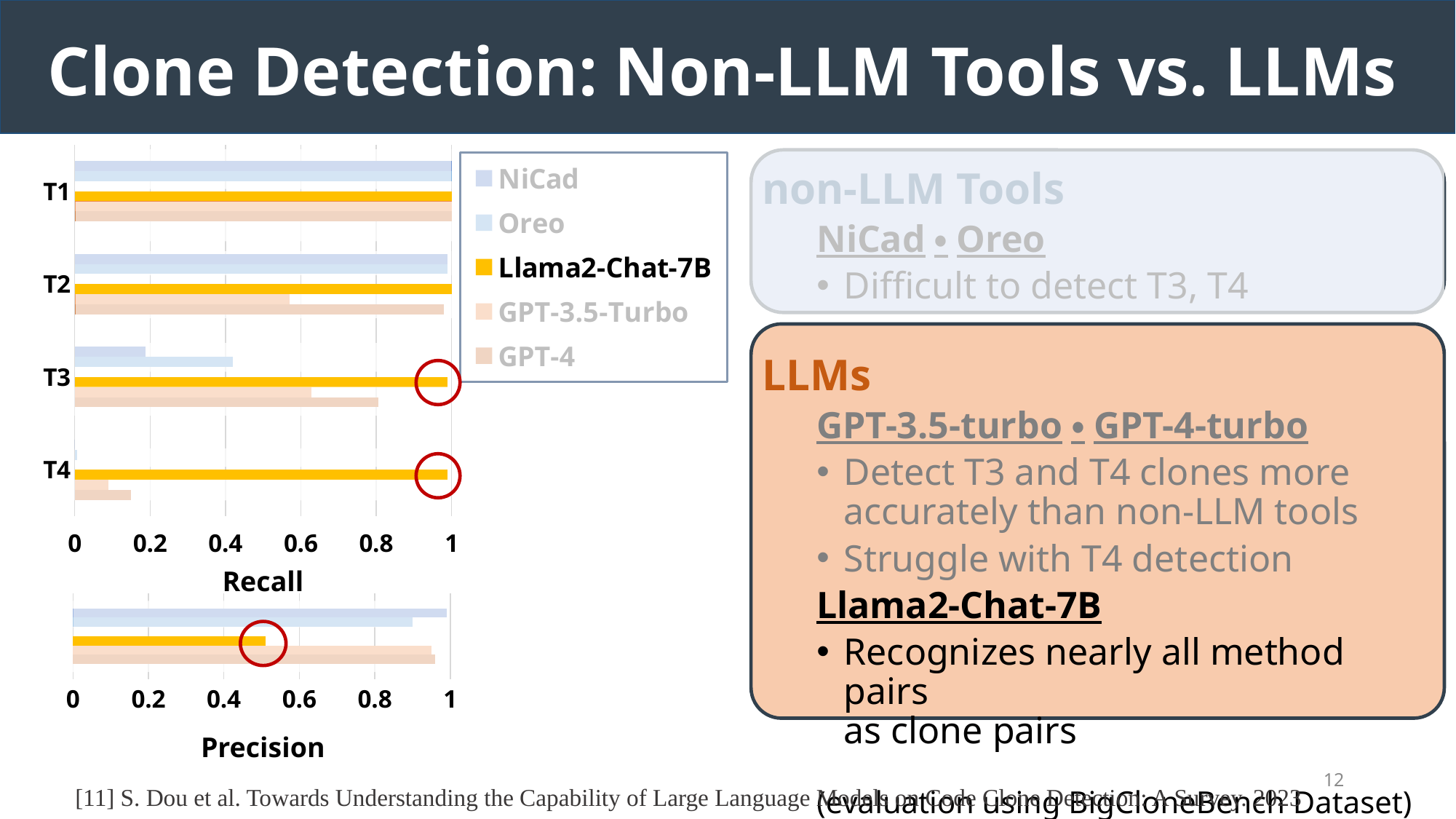
What is the x-axis label of the bottom chart on the slide? Precision How many series does the legend of the Recall chart list? 5 In the Recall chart, which series has the lowest recall for T3? NiCad What kind of chart is the Recall chart on the left of the slide? bar chart In the Recall chart, is the value for GPT-4 at T4 greater or less than 0.4? less In the Precision chart, is the value for Llama2-Chat-7B greater or less than 0.8? less In the Recall chart, is the value for NiCad at T3 greater or less than 0.4? less In the Precision chart, which series has the lowest precision? Llama2-Chat-7B How many categories (clone types) are shown on the Recall chart? 4 In the Recall chart, which is larger for T4: the recall of Llama2-Chat-7B or of GPT-3.5-Turbo? Llama2-Chat-7B In the Recall chart, which series has the highest recall for T4? Llama2-Chat-7B